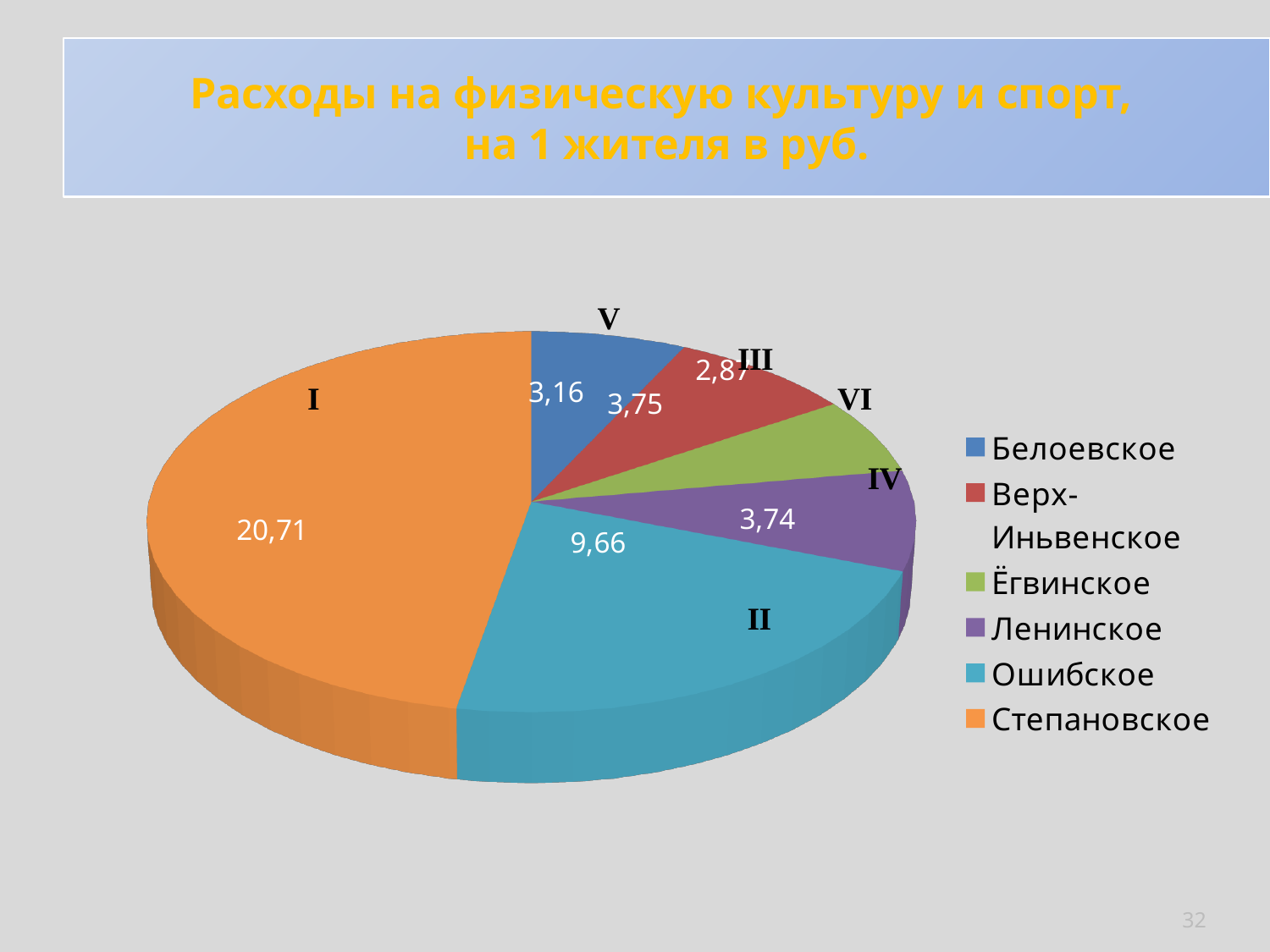
Which is larger, the value for Ошибское or the value for Белоевское? Ошибское What is the value for Степановское? 20,71 Which category has the smallest slice of the pie? Ёгвинское Which category has the largest slice of the pie? Степановское What is the value for Верх-Иньвенское? 3,75 What is the value for Белоевское? 3,16 How many categories does the pie chart show? 6 What is the value for Ошибское? 9,66 What kind of chart is shown on the slide? pie chart What is the difference between the values for Степановское and Ошибское? 11,05 Which Roman numeral rank label is placed on the Степановское slice? I What is the value for Ленинское? 3,74